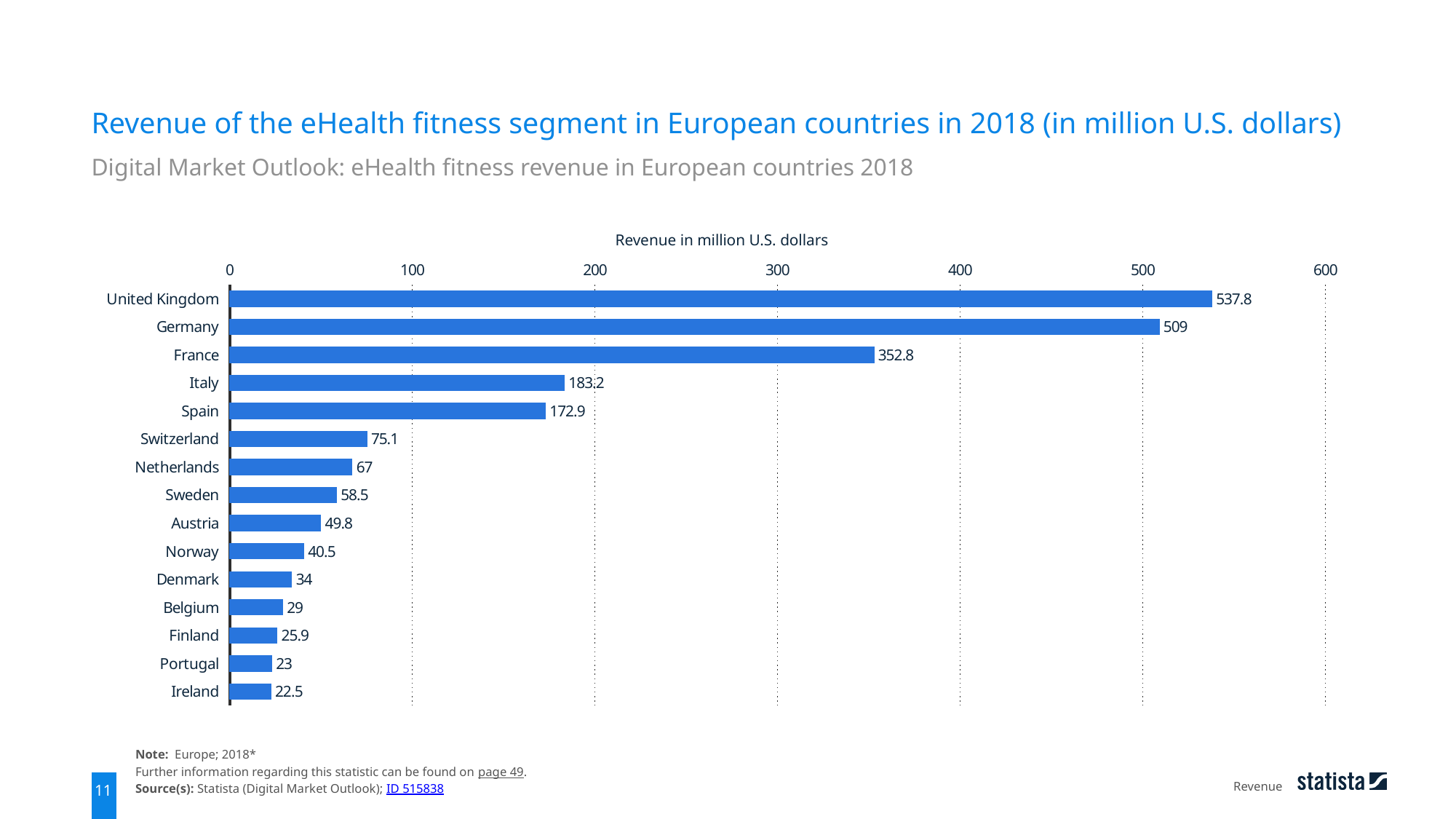
What is the eHealth fitness revenue for Germany in 2018? 509 Which has a higher revenue, Switzerland or the Netherlands? Switzerland What is the eHealth fitness revenue for Spain in 2018? 172.9 What is the eHealth fitness revenue for Norway in 2018? 40.5 Is the value for France greater or less than 300? greater Which country has the lowest eHealth fitness revenue? Ireland What kind of chart is shown on the slide? Bar chart What is the difference in revenue between Italy and Spain? 10.3 Which country has the highest eHealth fitness revenue? United Kingdom What is the difference in revenue between the United Kingdom and Germany? 28.8 How many countries are shown in the chart? 15 What is the label of the horizontal axis? Revenue in million U.S. dollars